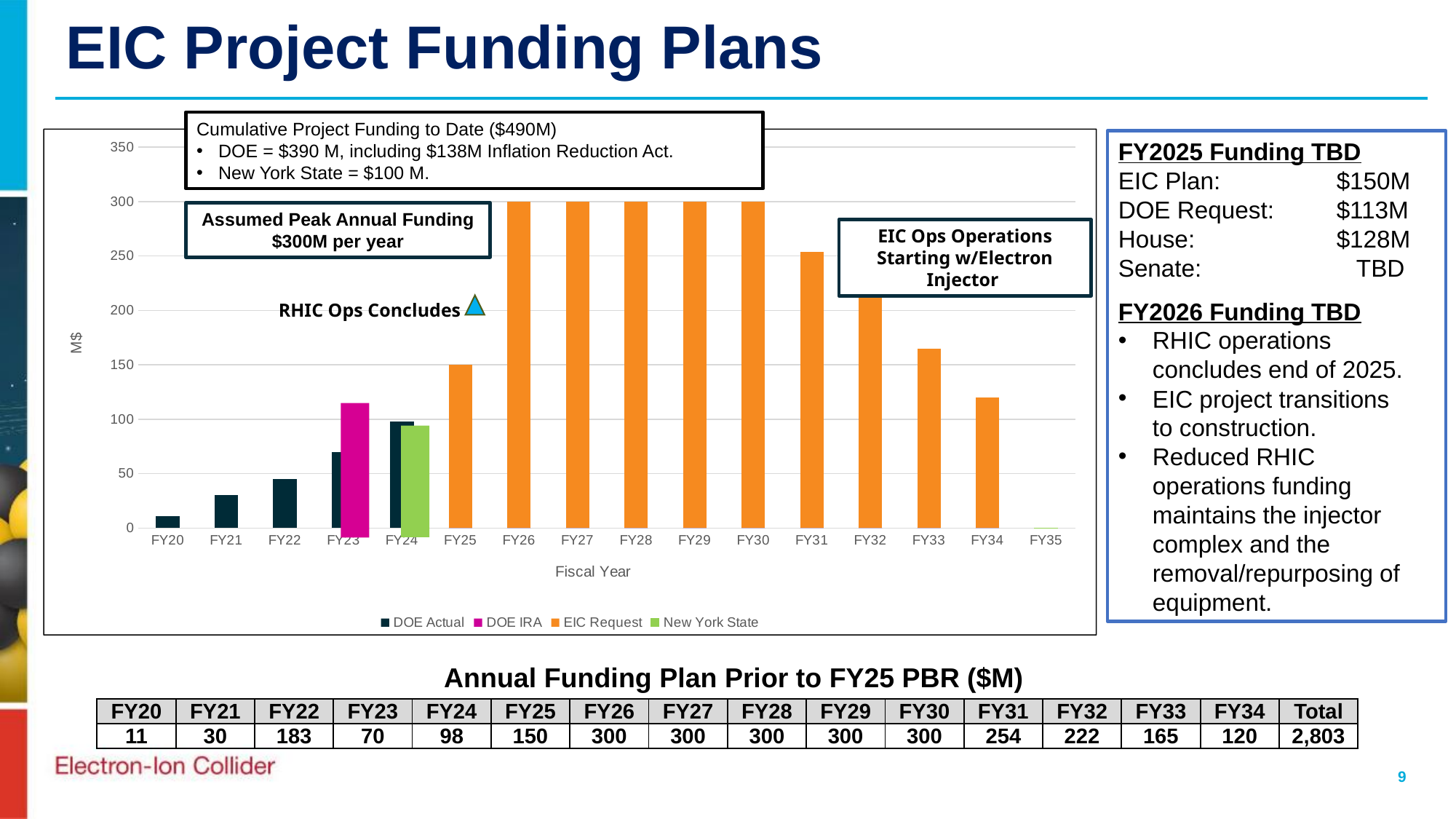
What is the EIC Request value for FY34 in $M? 120 How many fiscal years are shown on the x axis of the chart? 16 What is the EIC Request value for FY31 in $M? 254 Do the EIC Request bars rise or fall from FY30 to FY34? fall Is the DOE IRA value for FY23 greater or less than 100? greater Which fiscal year has the lowest DOE Actual bar? FY20 What kind of chart is shown on the slide? bar chart How many series does the chart legend list? 4 What is the EIC Request value for FY26 in $M? 300 Which series has the tallest bars in the chart? EIC Request Which is larger, the EIC Request bar for FY31 or for FY33? FY31 What is the EIC Request value for FY25 in $M? 150